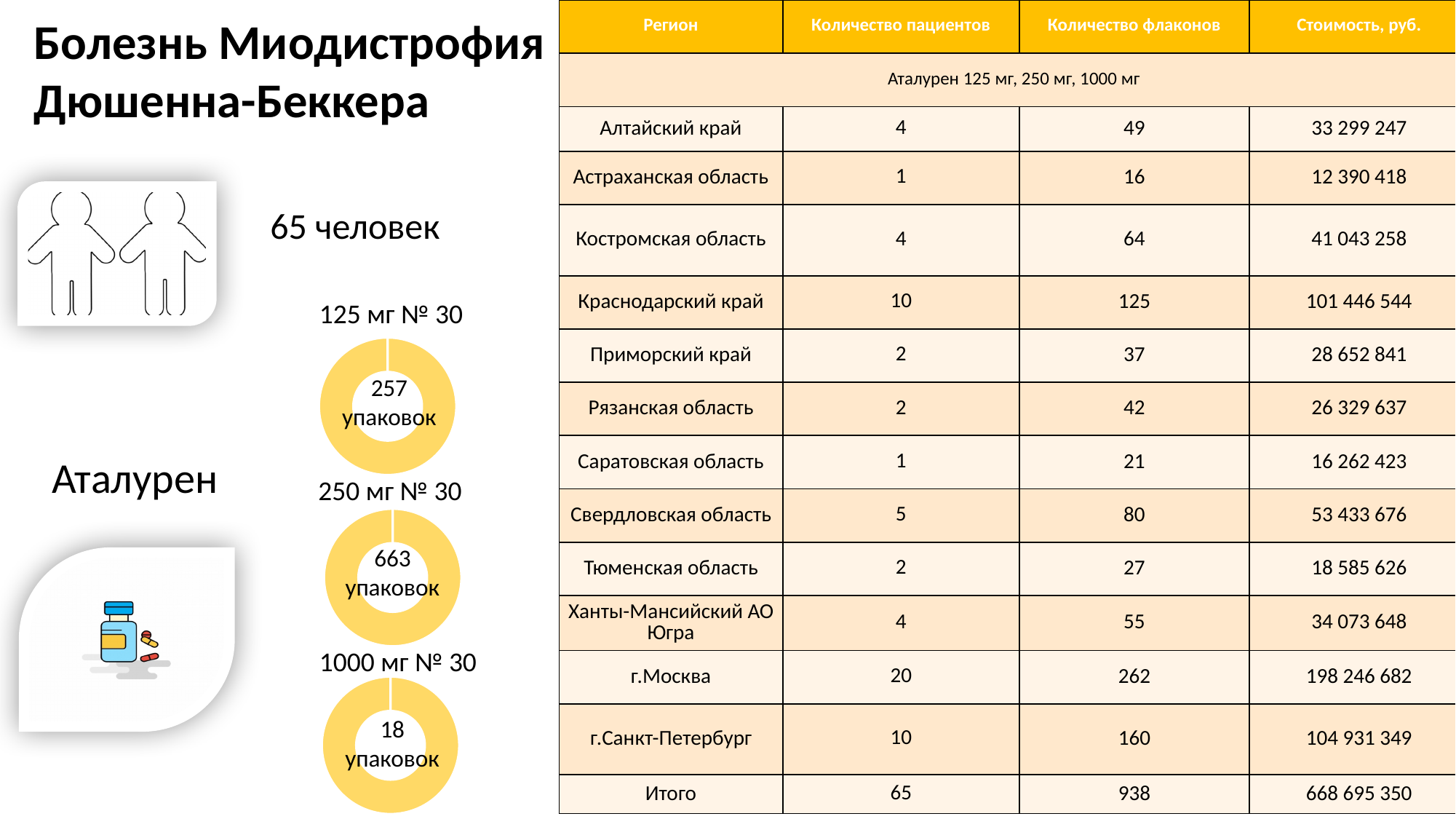
How many donut charts are shown on the slide? 3 What value is shown in the centre of the donut chart titled "125 мг № 30"? 257 упаковок What is the difference in packs between the "250 мг № 30" donut chart and the "125 мг № 30" donut chart? 406 What value is shown in the centre of the donut chart titled "250 мг № 30"? 663 упаковок What kind of charts are the three charts under the "65 человек" label on the left side of the slide? Donut charts What value is shown in the centre of the donut chart titled "1000 мг № 30"? 18 упаковок What is the title of the topmost donut chart on the slide? 125 мг № 30 Which of the three donut charts shows the smallest number of packs (упаковок)? 1000 мг № 30 What colour are the rings of the three donut charts? Yellow Which shows more packs: the "125 мг № 30" donut chart or the "1000 мг № 30" donut chart? 125 мг № 30 What is the total number of packs across the three donut charts (125 мг, 250 мг and 1000 мг)? 938 Which of the three donut charts shows the largest number of packs (упаковок)? 250 мг № 30